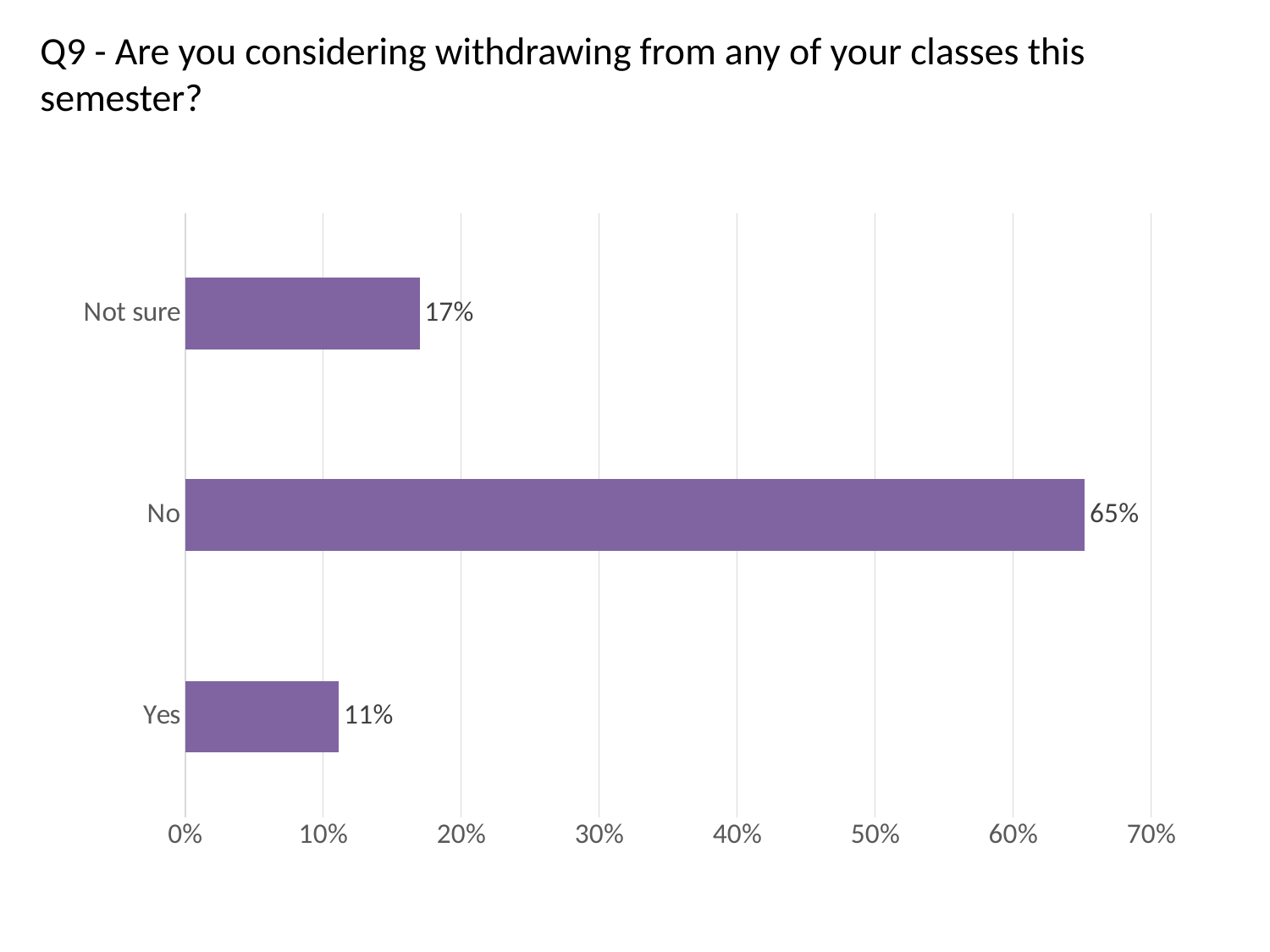
Which response has the highest percentage? No What kind of chart is shown on the slide? Bar chart Which response has the lowest percentage? Yes What percentage of respondents answered "No"? 65% What percentage of respondents answered "Yes"? 11% What is the highest value shown on the horizontal axis? 70% What is the difference in percentage points between "No" and "Yes"? 54 Is the value for "No" greater or less than 60%? greater What percentage of respondents answered "Not sure"? 17% Which is larger, the percentage for "Not sure" or for "Yes"? Not sure How many response categories are shown in the chart? 3 What is the difference in percentage points between "Not sure" and "Yes"? 6